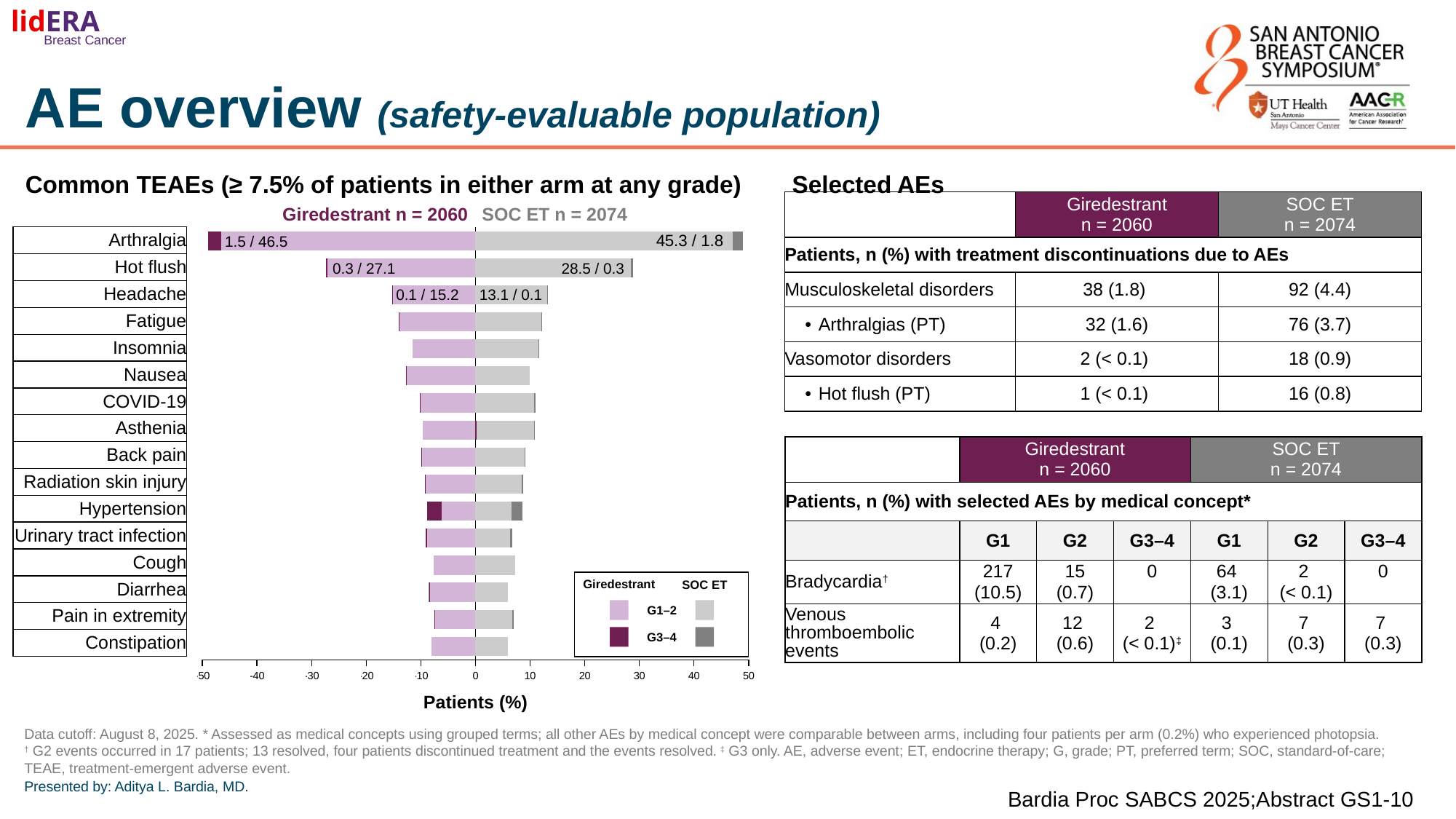
In the Common TEAEs chart, what is the SOC ET G1–2 value for Arthralgia? 45.3 How many TEAE categories are listed in the Common TEAEs chart? 16 In the Common TEAEs chart, for Hot flush, which arm has the larger G1–2 value, giredestrant or SOC ET? SOC ET In the Common TEAEs chart, is the giredestrant G1–2 value for Constipation greater or less than 10? less What type of chart is the Common TEAEs chart? Bar chart In the Common TEAEs chart, what is the giredestrant G1–2 value for Arthralgia? 46.5 In the Common TEAEs chart, which TEAE has the highest giredestrant G1–2 value? Arthralgia In the Common TEAEs chart, what is the giredestrant G1–2 value for Headache? 15.2 In the Common TEAEs chart, what is the difference between the giredestrant G1–2 values for Arthralgia and Hot flush? 19.4 In the Common TEAEs chart, what is the SOC ET G1–2 value for Hot flush? 28.5 In the Common TEAEs chart, what is the difference between the giredestrant G1–2 and SOC ET G1–2 values for Headache? 2.1 In the Common TEAEs chart, what is the giredestrant G3–4 value for Arthralgia? 1.5